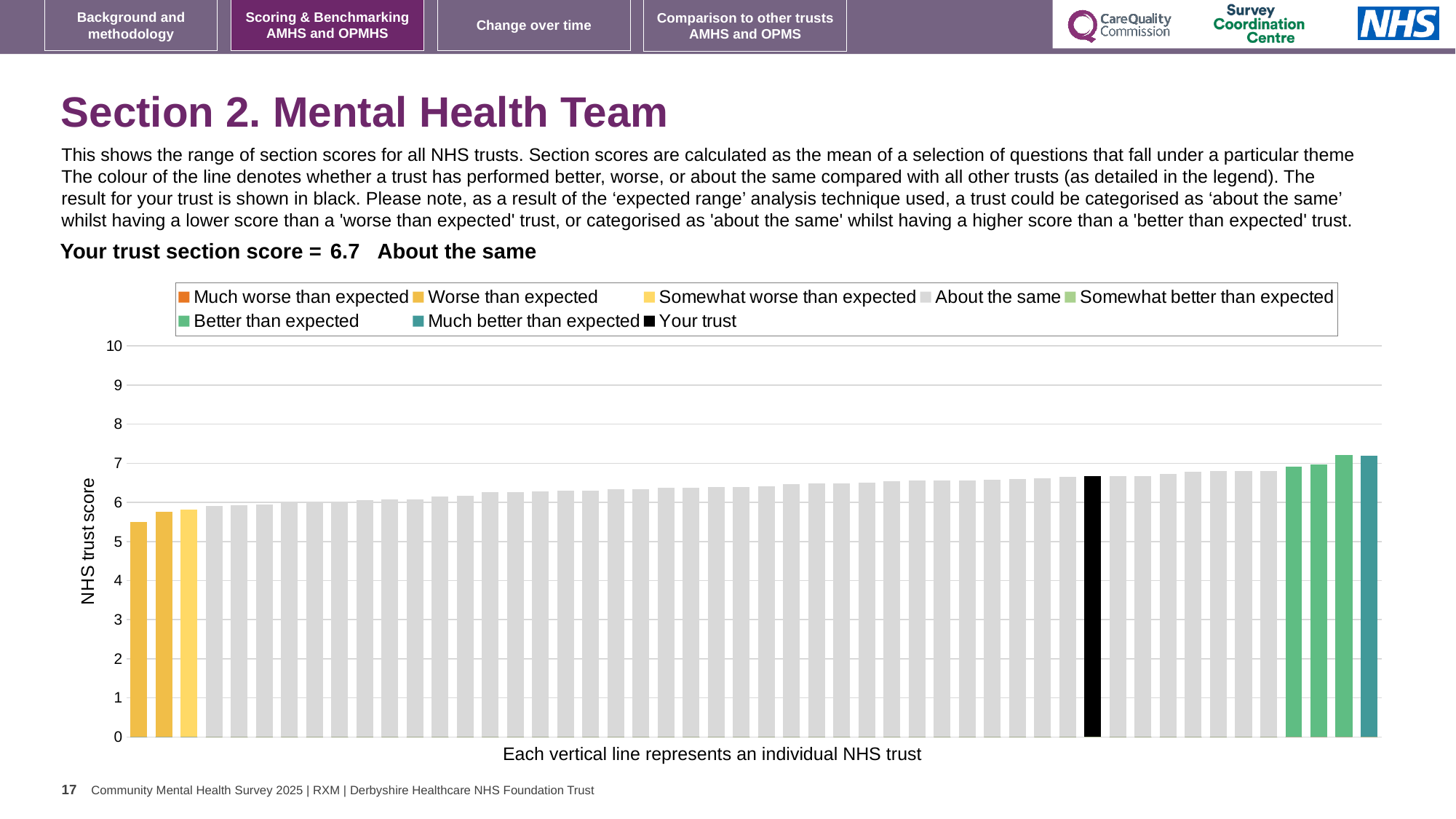
How many entries does the chart legend list? 8 Is the value of the black 'Your trust' bar greater or less than 7? less How many bars are coloured in the 'Worse than expected' colour at the left of the chart? 2 What colour is used for the 'Your trust' bar according to the legend? Black Which category is your trust's section score placed in? About the same Do the bar values rise or fall from left to right along the x axis? Rise Is the value of the lowest bar in the chart greater or less than 6? less What is the label on the vertical axis of the chart? NHS trust score Is the value of the black 'Your trust' bar greater or less than 6? greater What kind of chart is shown on the slide? Bar chart What is the section score for your trust shown on the slide? 6.7